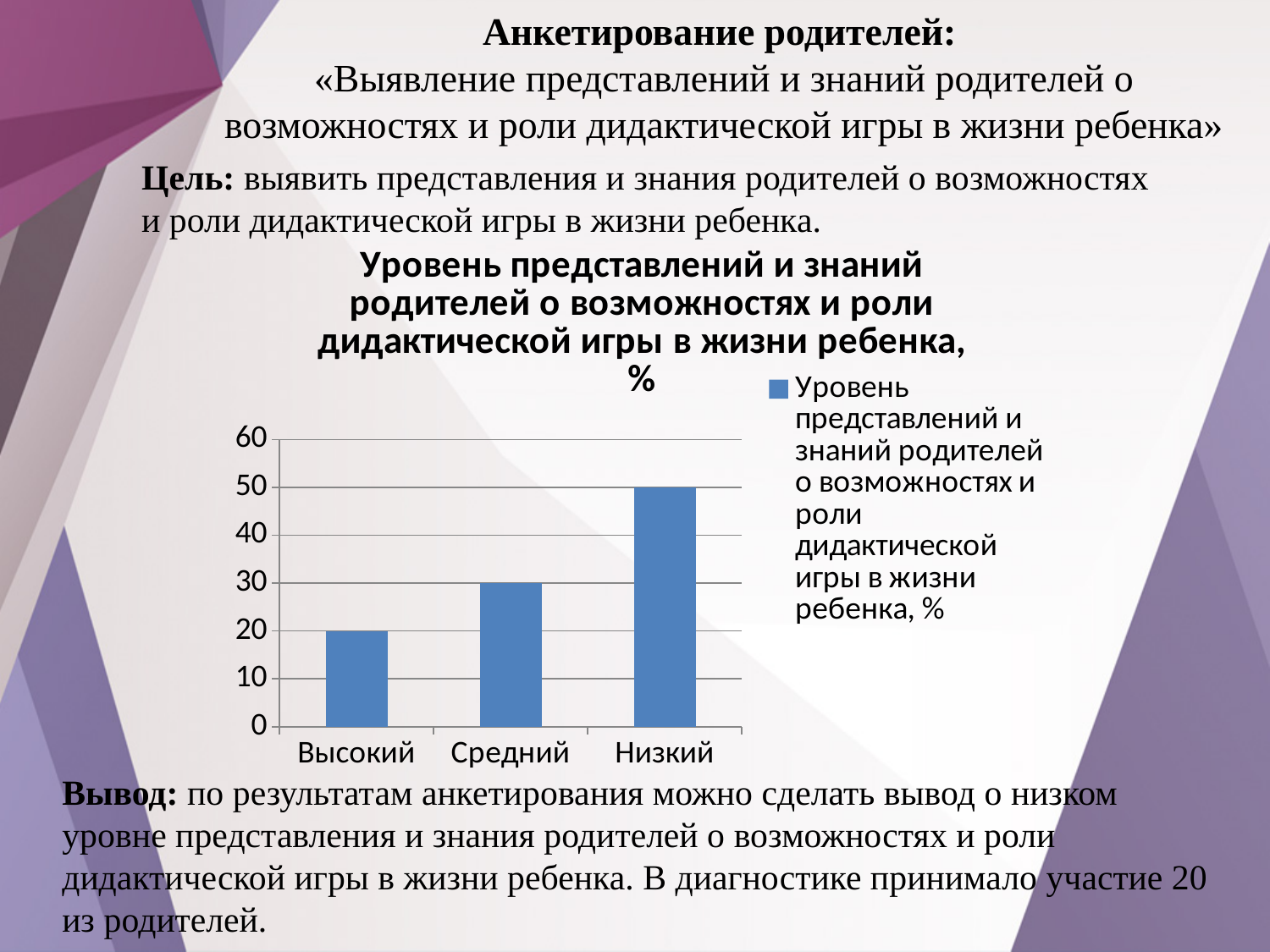
Which is larger, the value for Средний or the value for Высокий? Средний What is the value for the category Средний? 30 How many series does the chart legend list? 1 What is the highest value shown on the vertical axis of the chart? 60 Which category has the lowest value? Высокий What is the value for the category Высокий? 20 What is the value for the category Низкий? 50 What is the difference between the values for Низкий and Высокий? 30 What type of chart is shown on the slide? Bar chart How many categories are shown on the x axis of the chart? 3 Do the values rise or fall moving from Высокий to Низкий along the x axis? Rise Which category has the highest value? Низкий